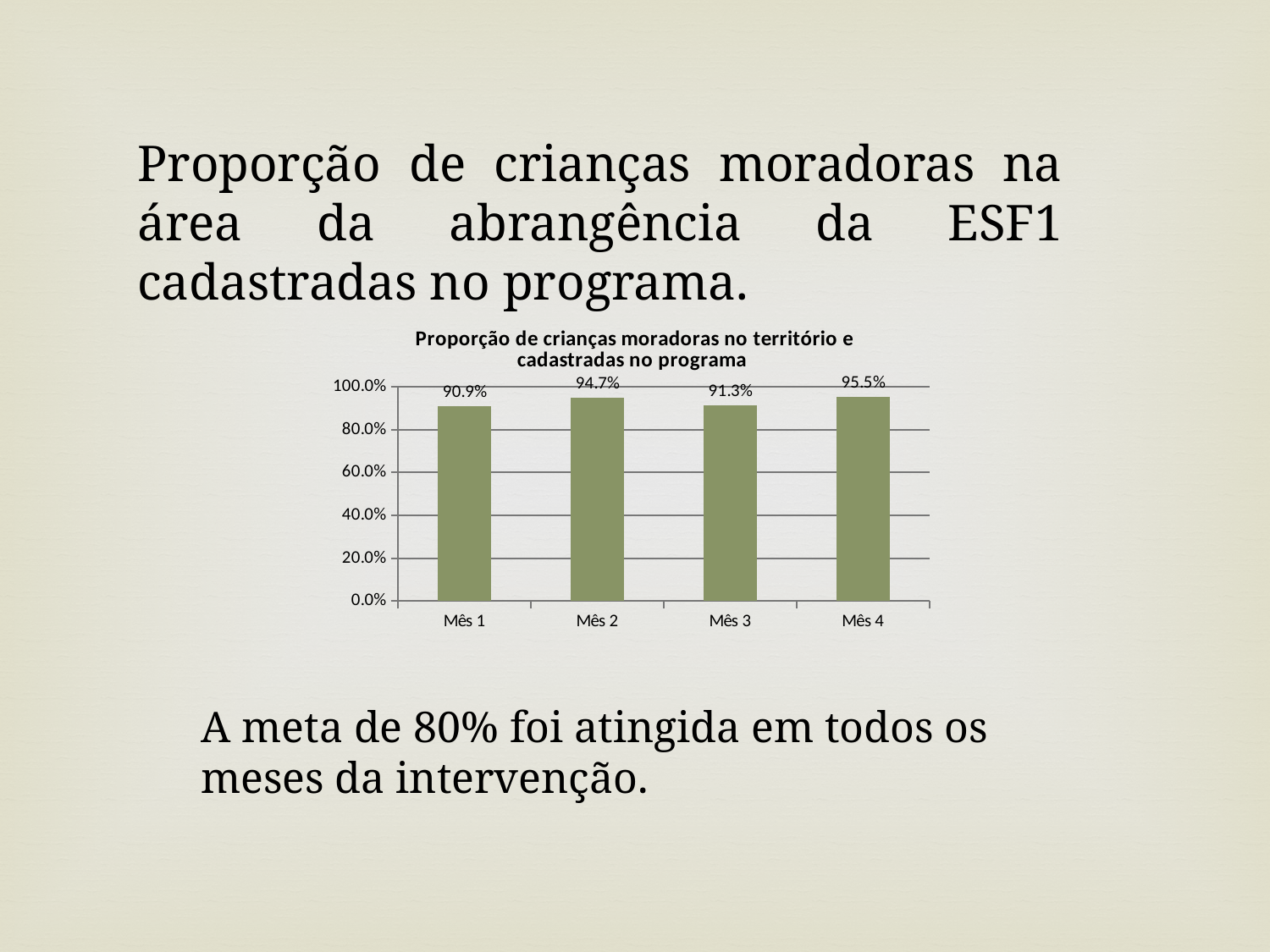
Which is larger, the value for Mês 2 or the value for Mês 3? Mês 2 What kind of chart is shown on the slide? bar chart What is the difference between the values for Mês 4 and Mês 1? 4.6% Is the value for Mês 3 greater or less than 80.0%? greater What is the value for Mês 3? 91.3% Which month has the lowest value? Mês 1 What is the value for Mês 4? 95.5% What is the value for Mês 1? 90.9% What is the value for Mês 2? 94.7% How many months are shown on the chart? 4 What is the title of the chart? Proporção de crianças moradoras no território e cadastradas no programa Which month has the highest value? Mês 4